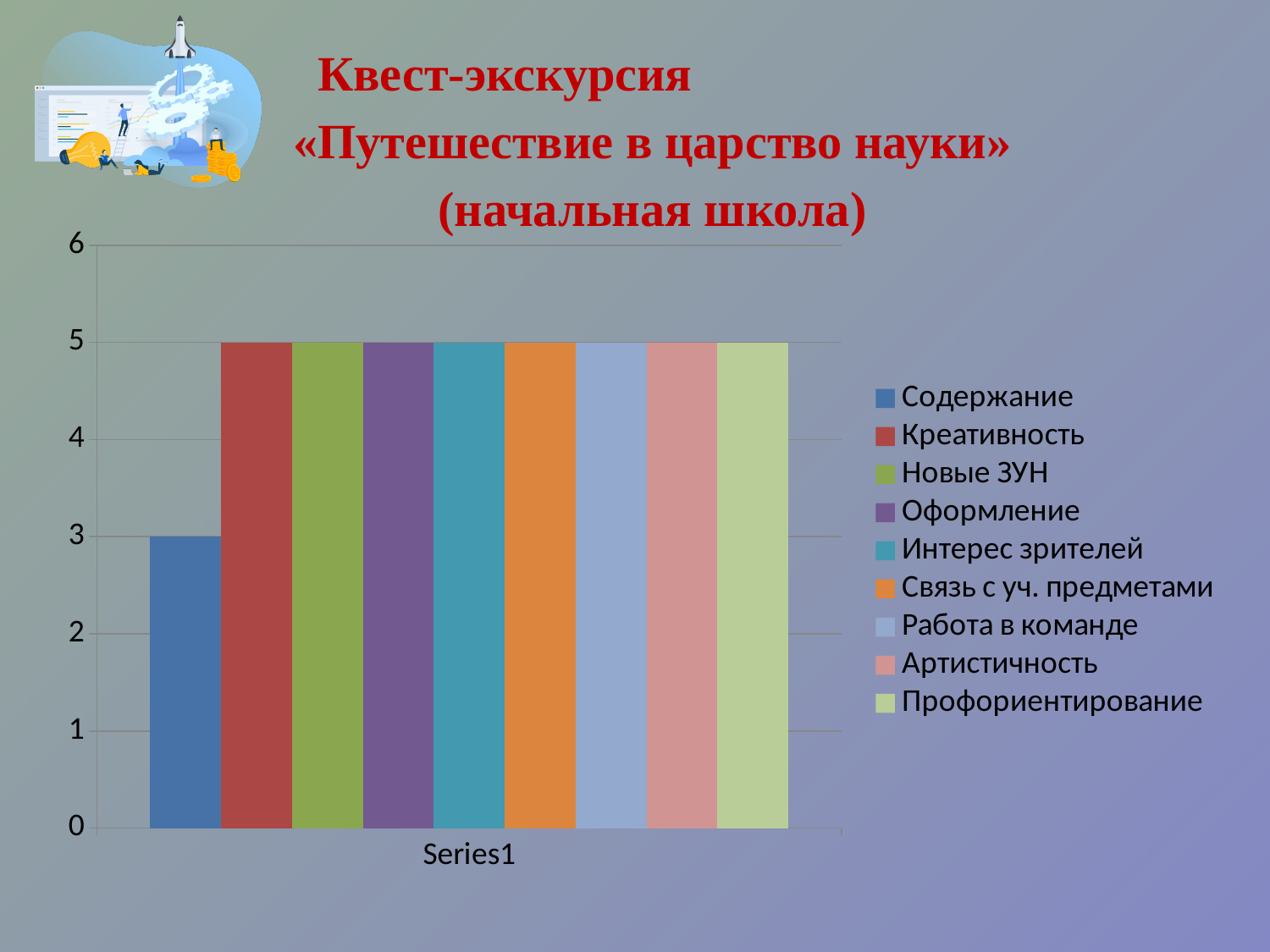
How many series does the legend list? 9 What kind of chart is shown on the slide? bar chart Is the value for Содержание greater or less than 4? less Is the value for Артистичность greater or less than 4? greater What is the value for Содержание? 3 What is the label shown on the x axis under the bars? Series1 What is the value for Креативность? 5 Which is larger, the value for Содержание or the value for Оформление? Оформление Which series has the lowest value? Содержание What is the difference between the value for Креативность and the value for Содержание? 2 What colour is the bar for Связь с уч. предметами? orange What is the value for Профориентирование? 5